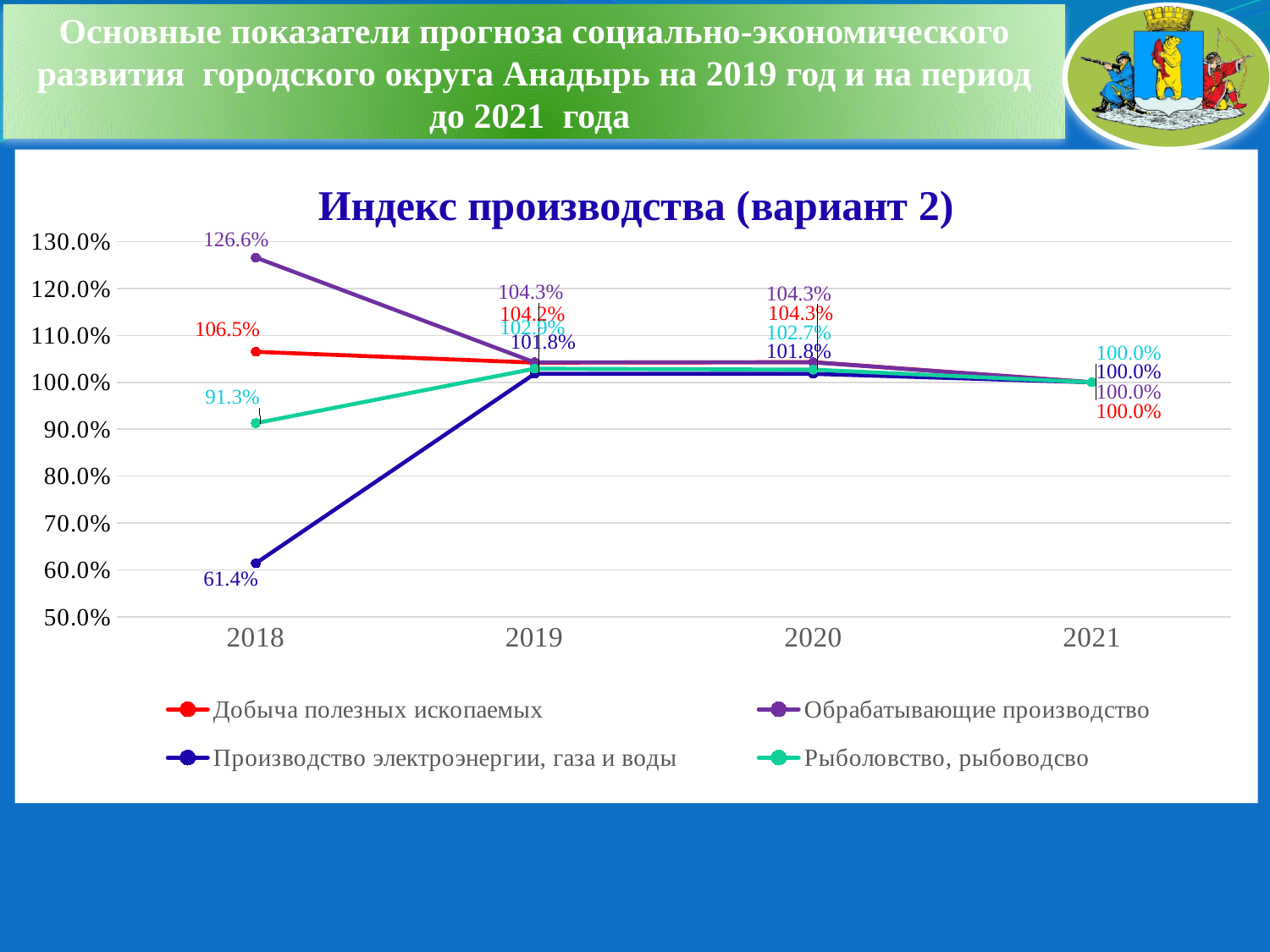
What is the title of the chart? Индекс производства (вариант 2) What is the difference between the 2018 values of Обрабатывающие производство and Производство электроэнергии, газа и воды? 65.2% Which series has the highest value in 2018? Обрабатывающие производство What is the value for Рыболовство, рыбоводсво in 2020? 102.7% Which series has the lowest value in 2018? Производство электроэнергии, газа и воды Does the value for Производство электроэнергии, газа и воды rise or fall from 2018 to 2019? rise What type of chart is shown on the slide? line chart What is the value for Рыболовство, рыбоводсво in 2018? 91.3% How many series does the legend list? 4 What is the value for Добыча полезных ископаемых in 2018? 106.5% What is the value for Производство электроэнергии, газа и воды in 2018? 61.4% What is the value for Обрабатывающие производство in 2018? 126.6%